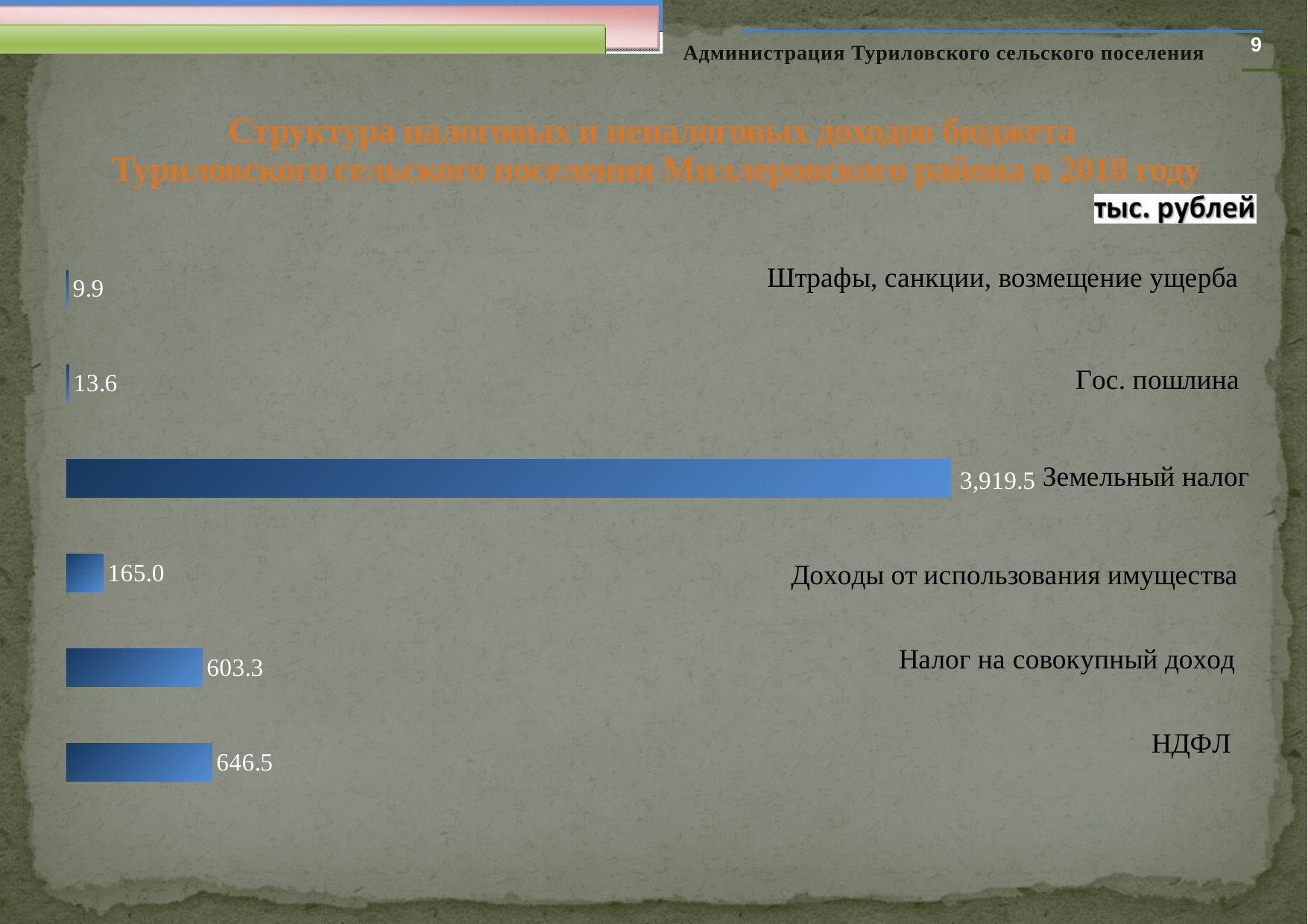
What is the value for Гос. пошлина? 13.6 What is the value for НДФЛ? 646.5 What is the difference between the values for Гос. пошлина and Штрафы, санкции, возмещение ущерба? 3.7 Which is larger, the value for Налог на совокупный доход or the value for Доходы от использования имущества? Налог на совокупный доход What is the value for Земельный налог? 3,919.5 Which category has the lowest value? Штрафы, санкции, возмещение ущерба What is the difference between the values for НДФЛ and Налог на совокупный доход? 43.2 In what units are the chart values given? тыс. рублей How many categories are shown in the chart? 6 Which category has the highest value? Земельный налог What is the value for Доходы от использования имущества? 165.0 What kind of chart is shown on the slide? Bar chart